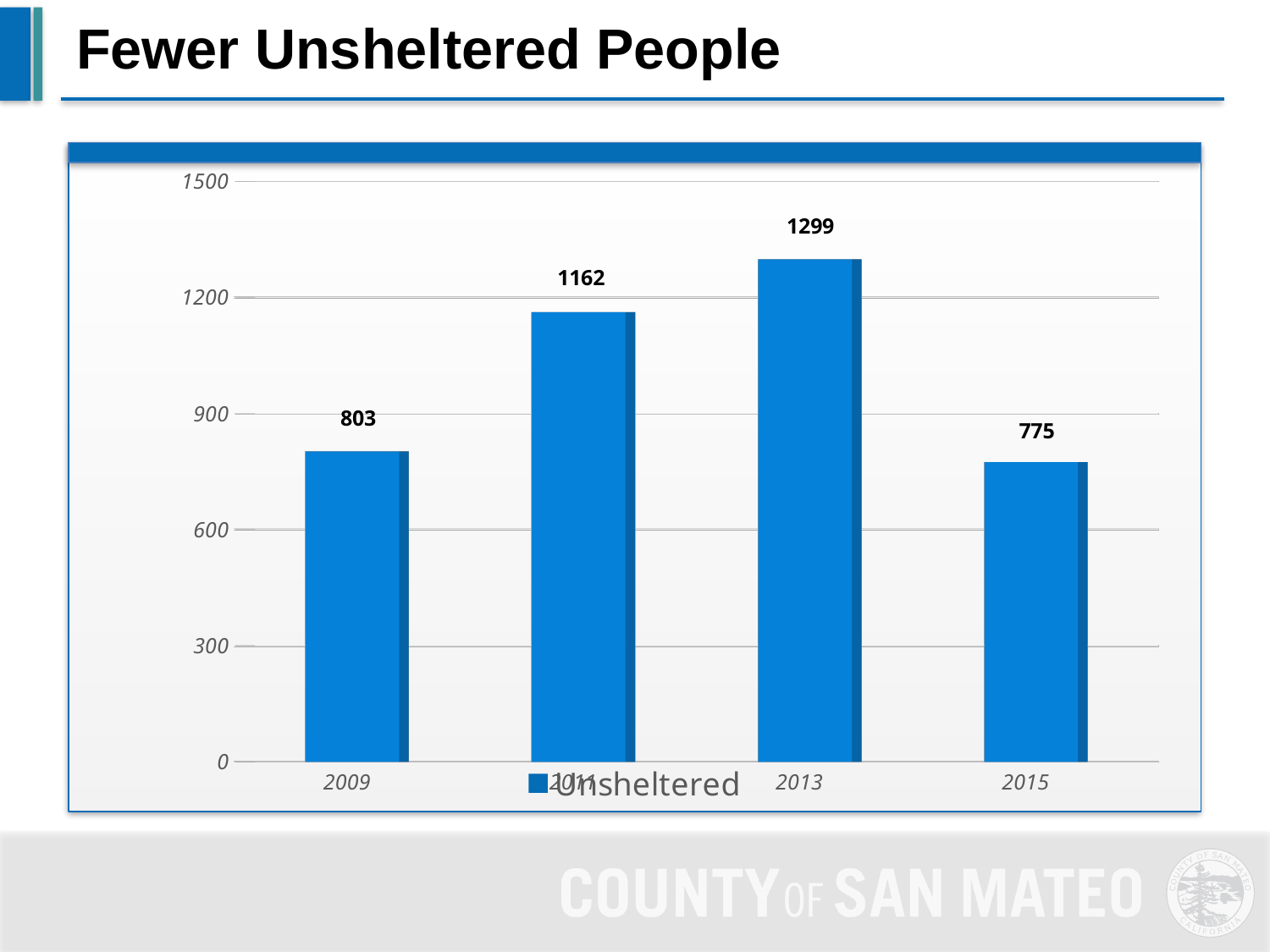
How many years are shown on the chart? 4 What is the number of unsheltered people in 2009? 803 What is the difference between the unsheltered counts for 2011 and 2009? 359 Is the value for 2011 greater or less than 900? greater Which is larger, the unsheltered count for 2009 or for 2015? 2009 What is the number of unsheltered people in 2013? 1299 What kind of chart is shown on the slide? bar chart What is the difference between the unsheltered counts for 2013 and 2015? 524 What series name does the legend show? Unsheltered What is the number of unsheltered people in 2015? 775 Which year has the lowest number of unsheltered people? 2015 Which year has the highest number of unsheltered people? 2013